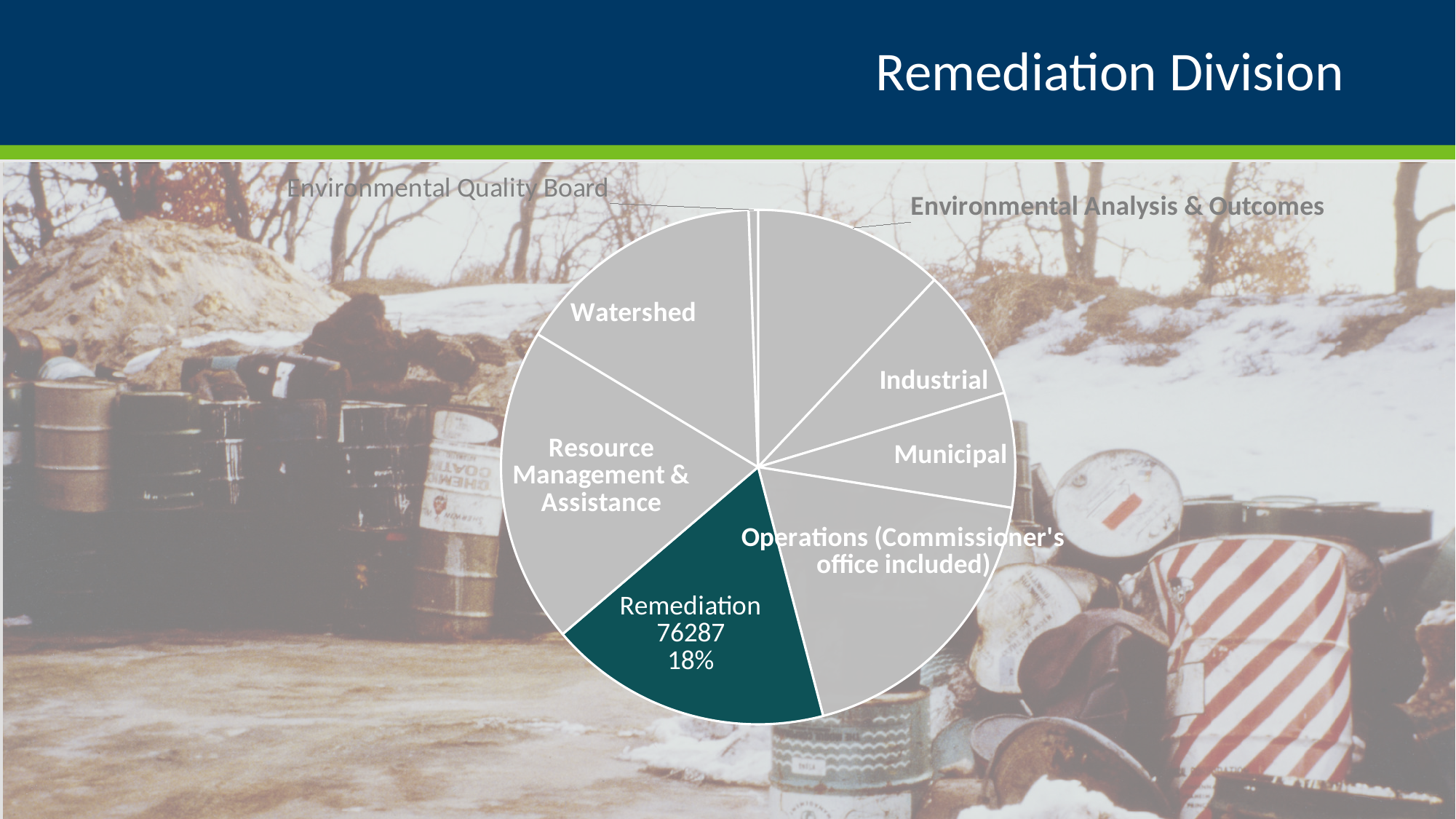
What share of the pie does the Remediation slice represent? 18% What kind of chart is shown on the slide? pie chart Which slice is larger, Environmental Analysis & Outcomes or Environmental Quality Board? Environmental Analysis & Outcomes Which slice is larger, Remediation or Environmental Quality Board? Remediation Which slice is larger, Watershed or Municipal? Watershed Which slice of the pie chart is highlighted in a dark teal colour while the others are grey? Remediation Which slice of the pie chart is the smallest? Environmental Quality Board What value is shown for the Remediation slice of the pie chart? 76287 How many slices does the pie chart have? 8 What is the title of the slide containing the pie chart? Remediation Division